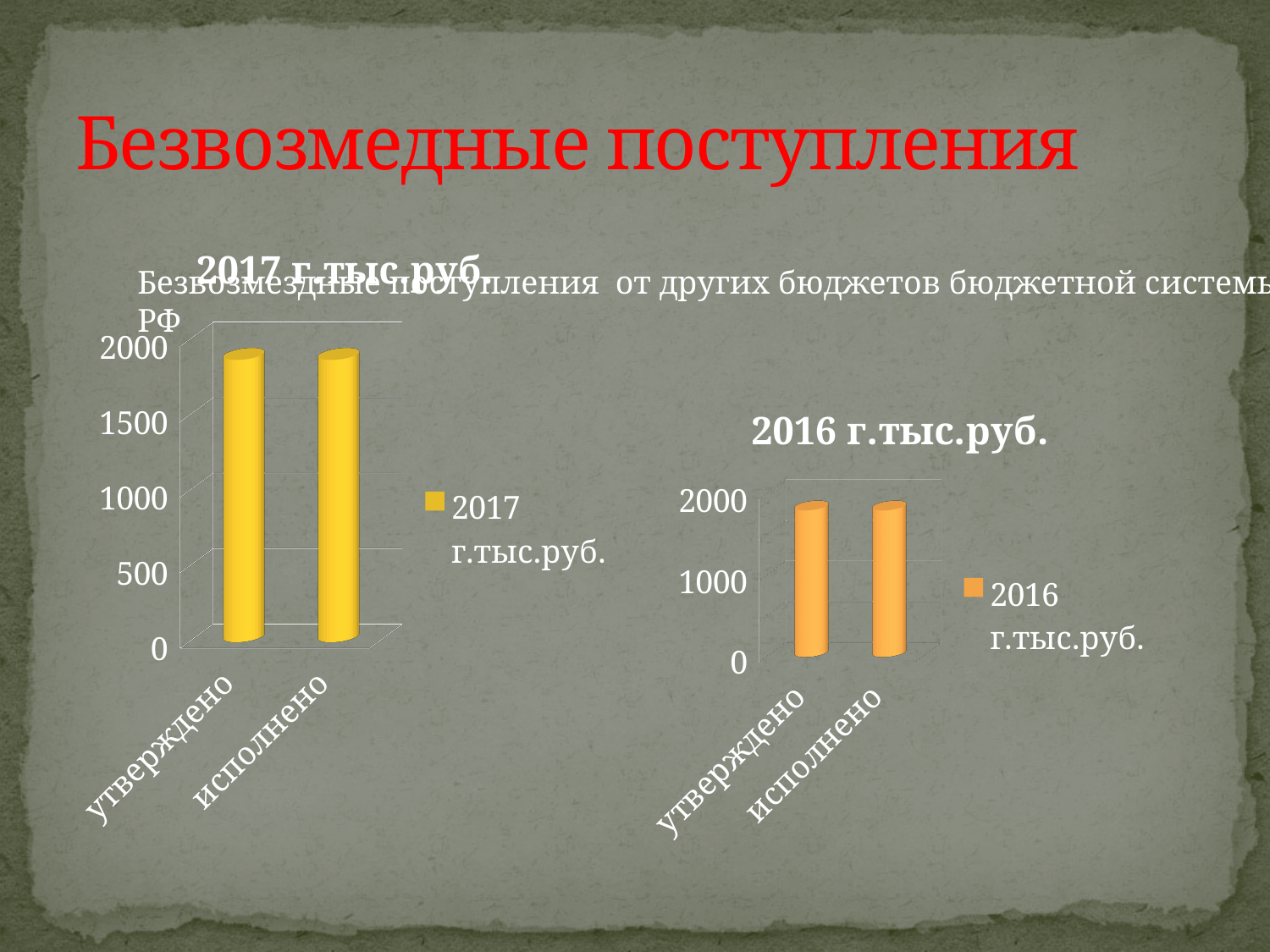
In the chart titled "2016 г.тыс.руб.", is the value for исполнено greater or less than 2000? less In the chart titled "2017 г.тыс.руб.", what kind of chart is shown? bar chart In the chart titled "2016 г.тыс.руб.", what kind of chart is shown? bar chart In the chart titled "2016 г.тыс.руб.", how many series does the legend list? 1 In the chart titled "2016 г.тыс.руб.", what is the legend entry? 2016 г.тыс.руб. In the chart titled "2017 г.тыс.руб.", how many series does the legend list? 1 How many charts are on the slide? 2 In the chart titled "2017 г.тыс.руб.", is the value for утверждено greater or less than 1500? greater In the chart titled "2017 г.тыс.руб.", how many categories are shown on the x axis? 2 In the chart titled "2016 г.тыс.руб.", is the value for утверждено greater or less than 1000? greater In the chart titled "2016 г.тыс.руб.", how many categories are shown on the x axis? 2